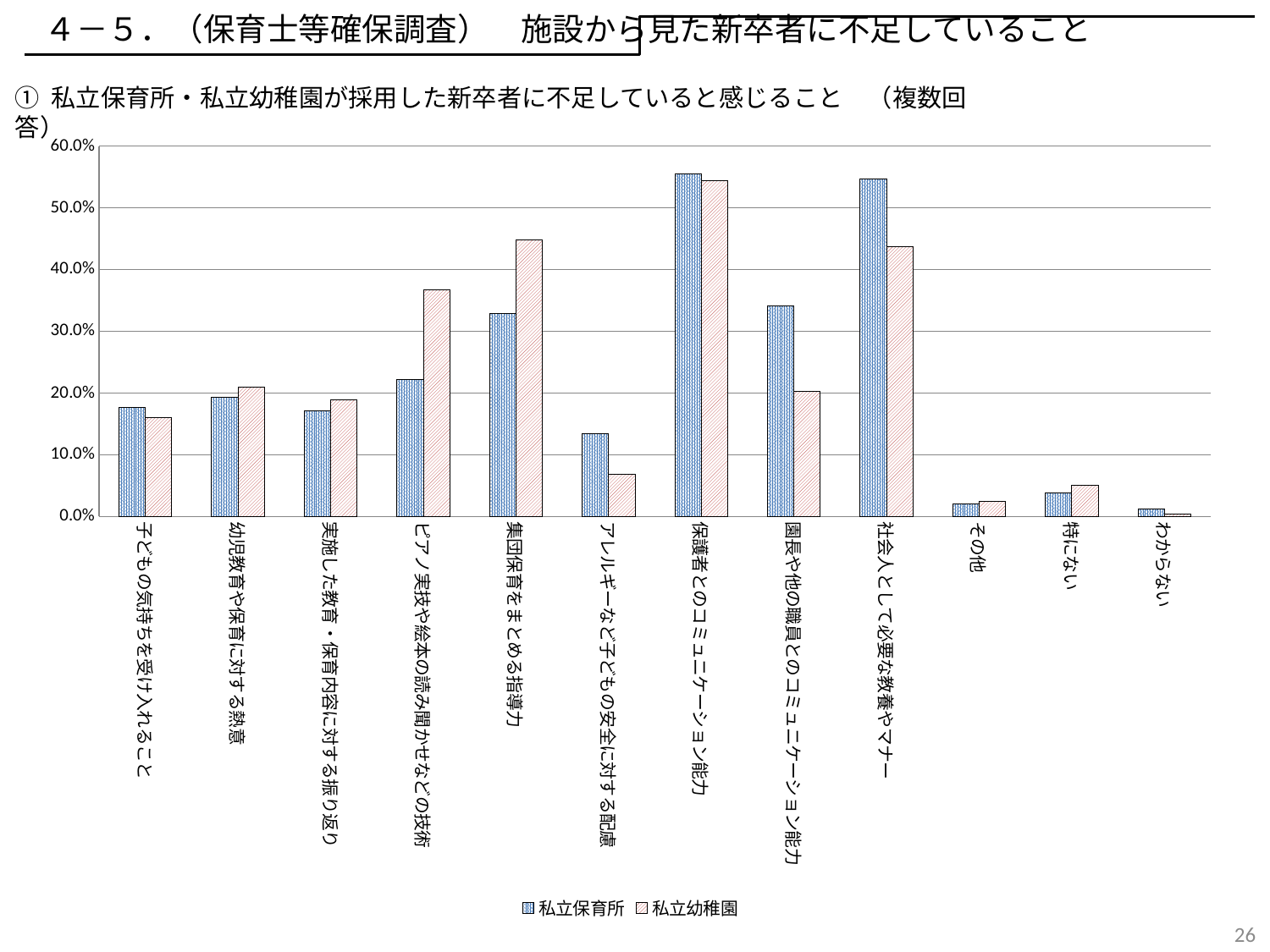
Is the 私立幼稚園 value for ピアノ実技や絵本の読み聞かせなどの技術 greater or less than 30.0%? greater How many series does the legend list? 2 Which category has the lowest value for 私立保育所? わからない Is the 私立保育所 value for アレルギーなど子どもの安全に対する配慮 greater or less than 10.0%? greater Which category has the highest value for 私立幼稚園? 保護者とのコミュニケーション能力 What kind of chart is shown on the slide? bar chart How many categories are shown on the x axis? 12 Which category has the lowest value for 私立幼稚園? わからない Is the 私立幼稚園 value for 子どもの気持ちを受け入れること greater or less than 20.0%? less What are the two series names listed in the legend? 私立保育所, 私立幼稚園 For 園長や他の職員とのコミュニケーション能力, which series has the larger value, 私立保育所 or 私立幼稚園? 私立保育所 For 集団保育をまとめる指導力, which series has the larger value, 私立保育所 or 私立幼稚園? 私立幼稚園